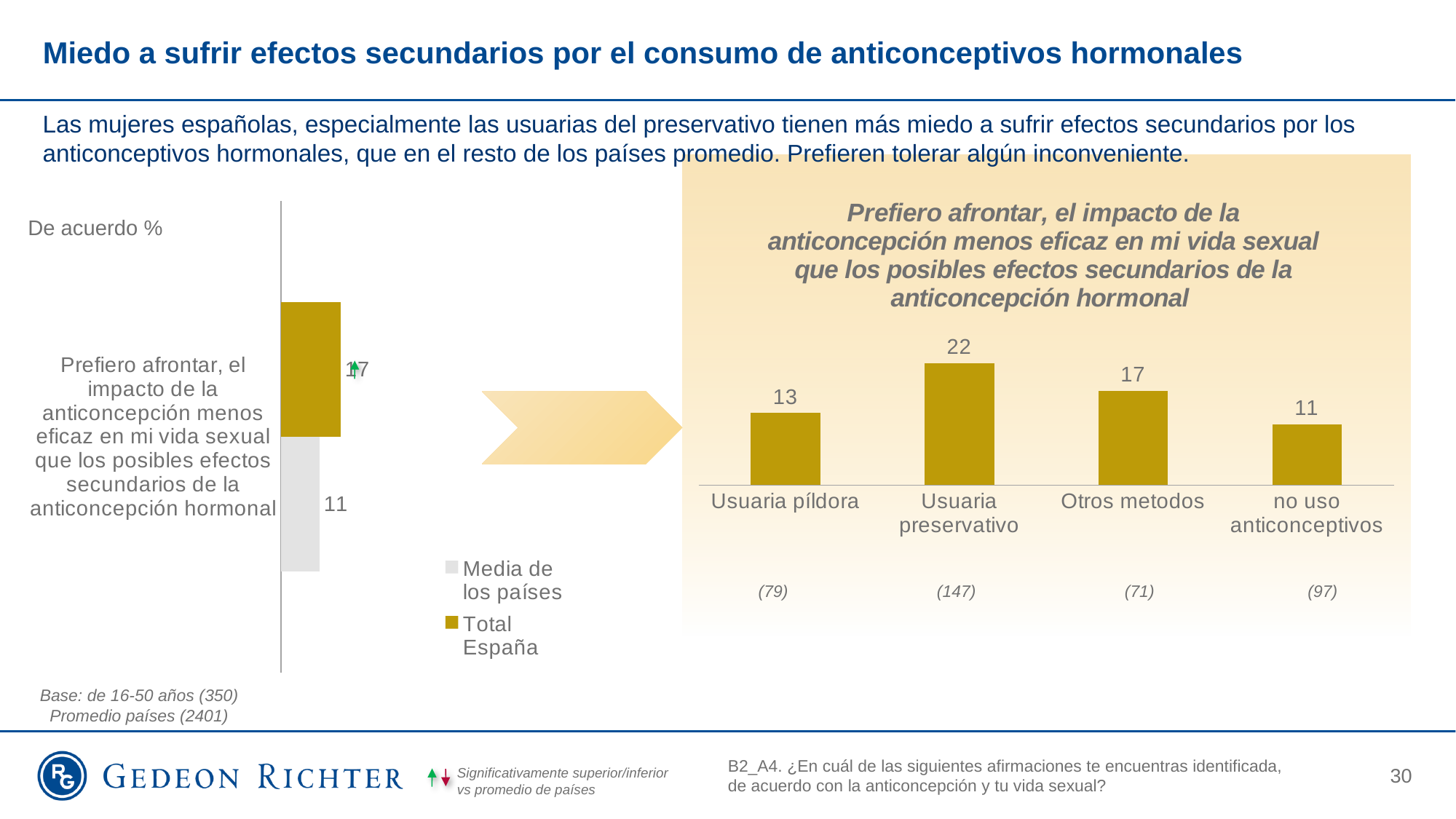
What kind of chart is the right chart? Bar chart In the left chart, what is the value for Media de los países? 11 In the right chart, which category has the lowest value? no uso anticonceptivos In the right chart, how many categories are shown? 4 In the right chart, what is the value for Otros metodos? 17 In the left chart, which is larger, Total España or Media de los países? Total España In the right chart, what is the value for Usuaria preservativo? 22 In the left chart, what is the difference between Total España and Media de los países? 6 In the right chart, which category has the highest value? Usuaria preservativo In the right chart, what is the difference between Usuaria preservativo and Usuaria píldora? 9 In the left chart, what is the value for Total España? 17 In the left chart, how many series does the legend list? 2